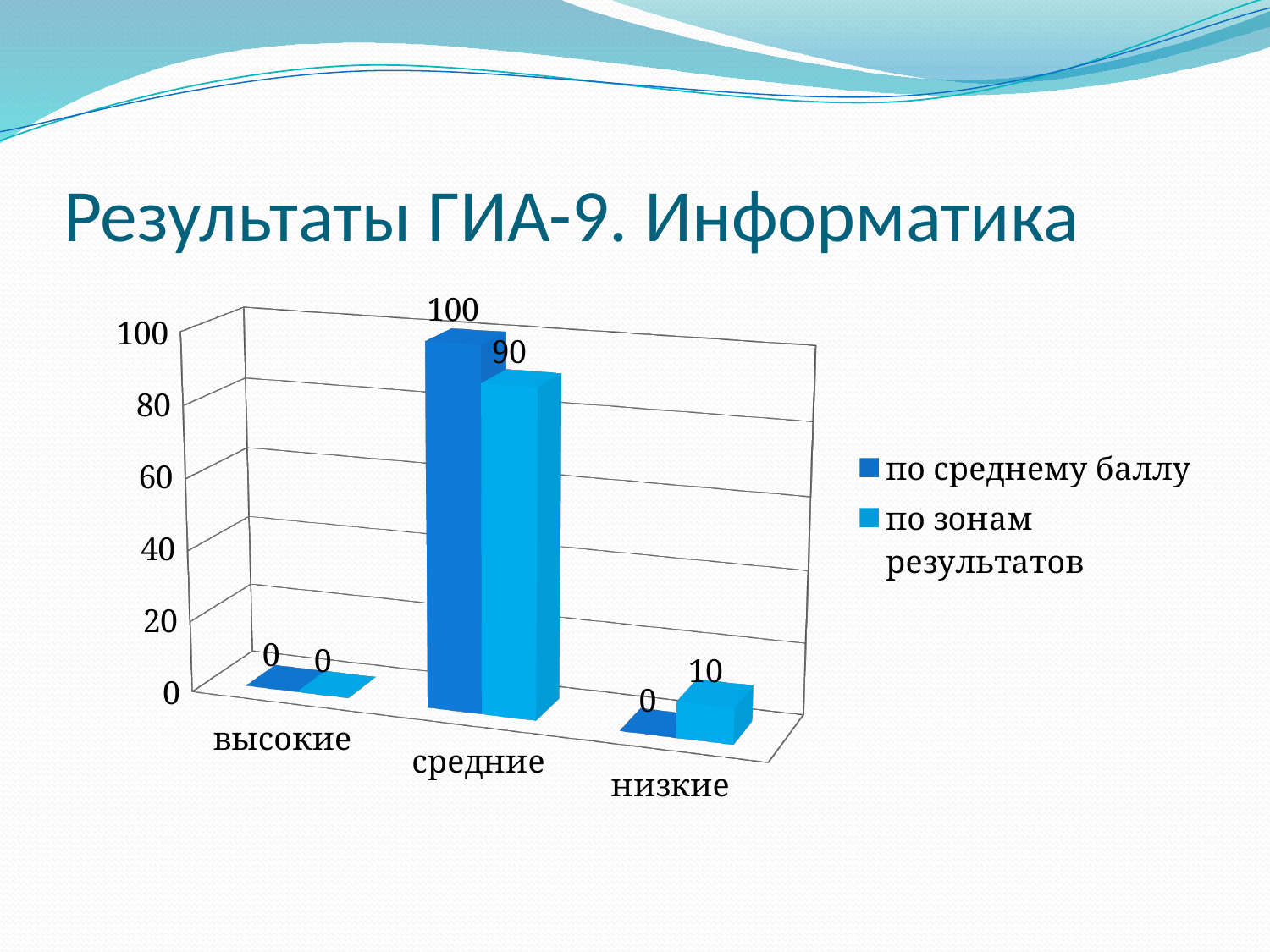
For 'низкие', which series has the larger value: 'по среднему баллу' or 'по зонам результатов'? по зонам результатов What is the difference between the 'по среднему баллу' and 'по зонам результатов' values for 'средние'? 10 How many categories are shown on the x axis? 3 What is the value for 'низкие' in the 'по зонам результатов' series? 10 What kind of chart is shown on the slide? bar chart Which category has the highest value in the 'по зонам результатов' series? средние What is the value for 'средние' in the 'по среднему баллу' series? 100 What is the difference between the 'по зонам результатов' values for 'средние' and 'низкие'? 80 How many series does the legend list? 2 What is the value for 'средние' in the 'по зонам результатов' series? 90 What is the value for 'высокие' in the 'по среднему баллу' series? 0 What is the title of the slide? Результаты ГИА-9. Информатика